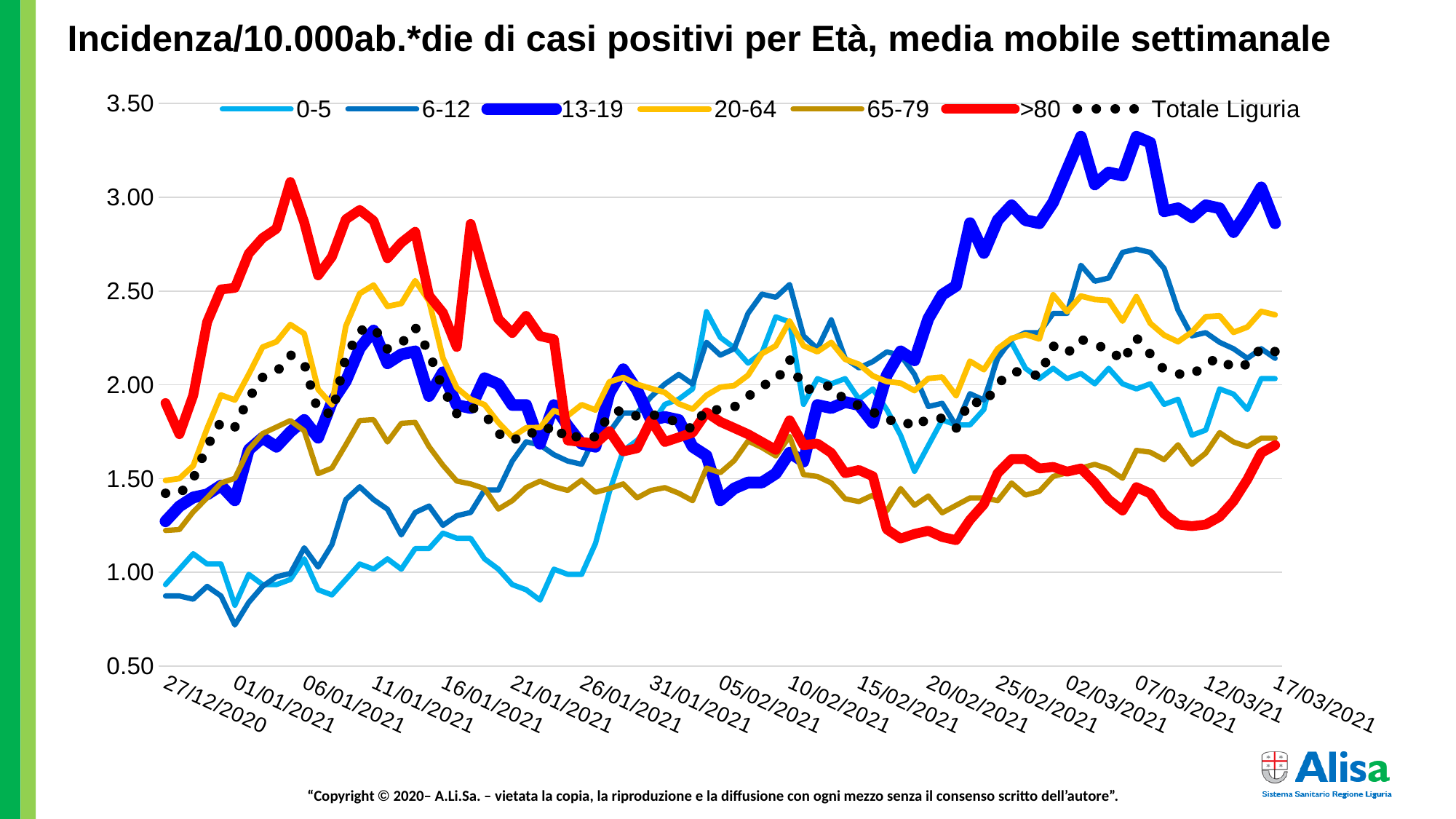
Does the 13-19 series rise or fall between 20/02/2021 and 02/03/2021? rise How many date labels are shown on the x axis? 17 Is the value for 13-19 at 17/03/2021 greater or less than 2.50? greater Which series reaches the highest peak anywhere on the chart? 13-19 What is the title of the chart? Incidenza/10.000ab.*die di casi positivi per Età, media mobile settimanale What kind of chart is shown on the slide? line chart Which series has the highest value at 17/03/2021? 13-19 At 27/12/2020, which is larger: the value for >80 or the value for 0-5? >80 How many series does the legend list? 7 Which series is drawn as a dotted black line? Totale Liguria Is the value for >80 at 17/03/2021 greater or less than 2.00? less Is the value for 6-12 at 27/12/2020 greater or less than 1.00? less